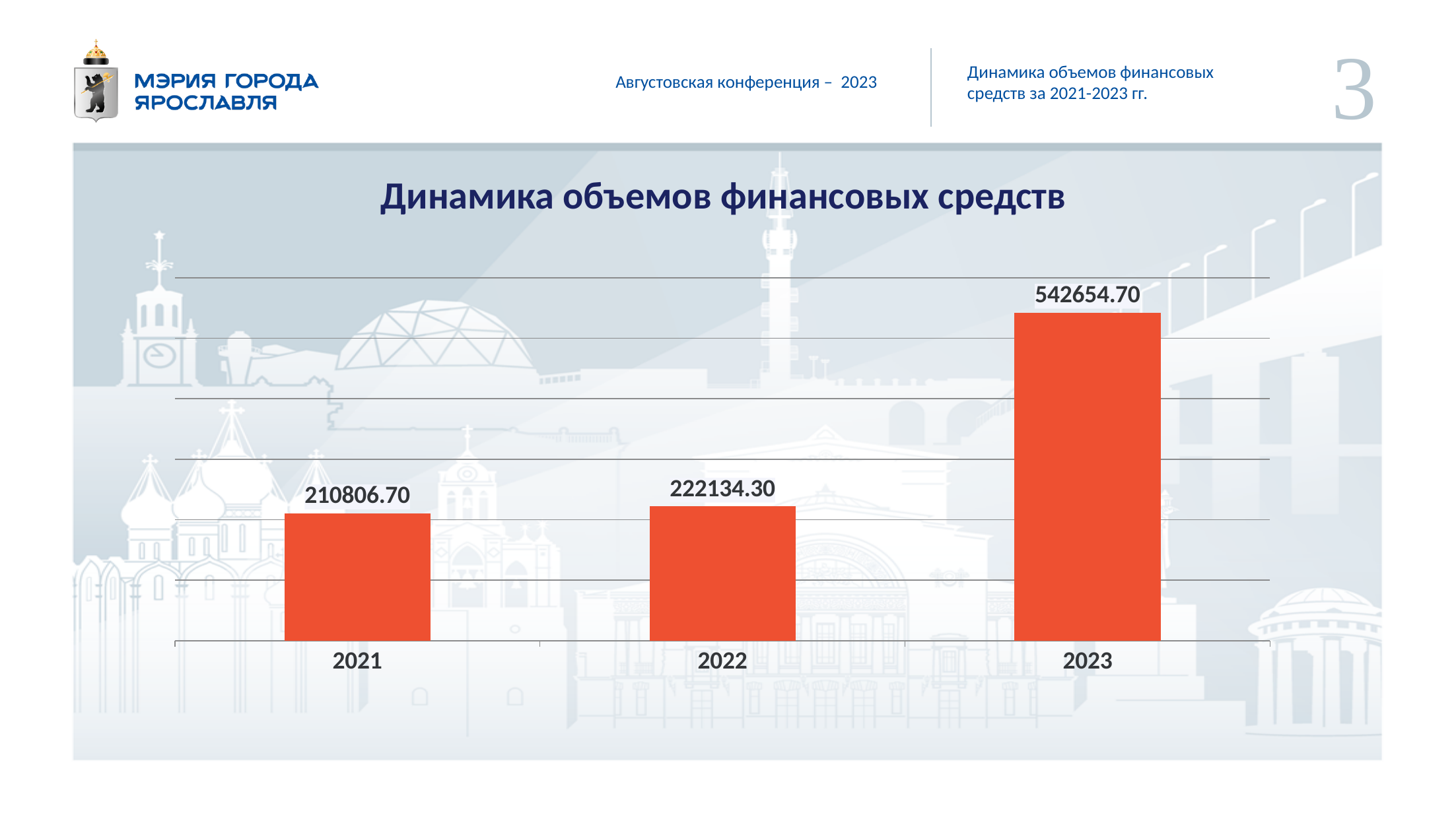
What is the difference between the values for 2022 and 2021? 11327.60 What is the title of the chart? Динамика объемов финансовых средств What is the difference between the values for 2023 and 2022? 320520.40 Do the values rise or fall from 2021 to 2023? Rise What kind of chart is shown on the slide? Bar chart Which year has the highest value? 2023 Which year has the lowest value? 2021 What is the value for 2023? 542654.70 What is the value for 2022? 222134.30 Which is larger, the value for 2021 or the value for 2023? 2023 What is the value for 2021? 210806.70 How many years are shown on the chart? 3